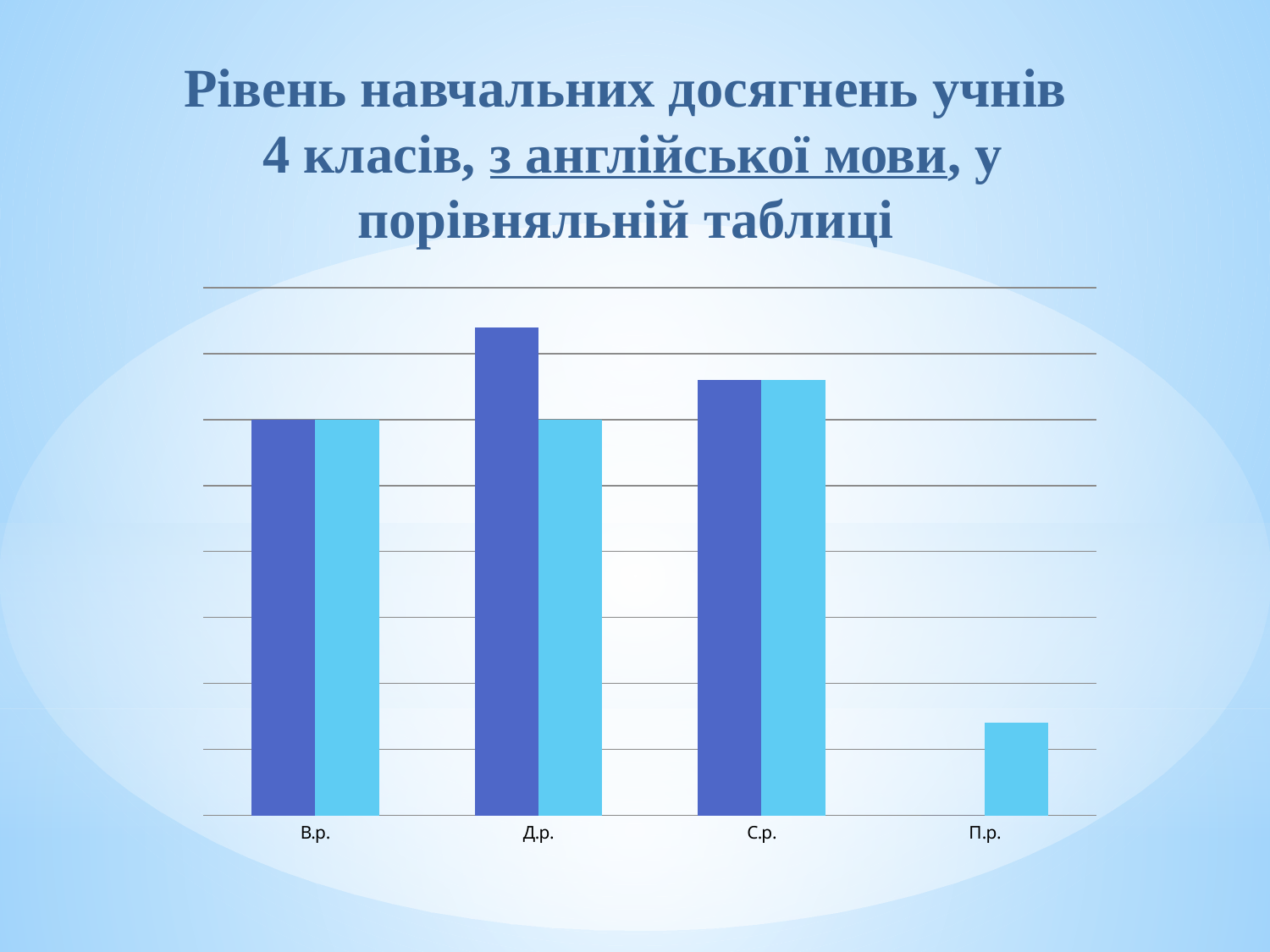
What kind of chart is shown on the slide? bar chart Which category has the tallest dark blue bar? Д.р. How many categories are shown on the x axis of the chart? 4 Which category has the tallest light blue bar? С.р. Is the dark blue bar taller for С.р. or for Д.р.? Д.р. Which category has the shortest light blue bar? П.р. Which subject is named in the slide title above the chart? англійської мови Is the dark blue bar taller for Д.р. or for В.р.? Д.р. Which category has only a light blue bar and no dark blue bar? П.р. Is the light blue bar taller for С.р. or for В.р.? С.р.